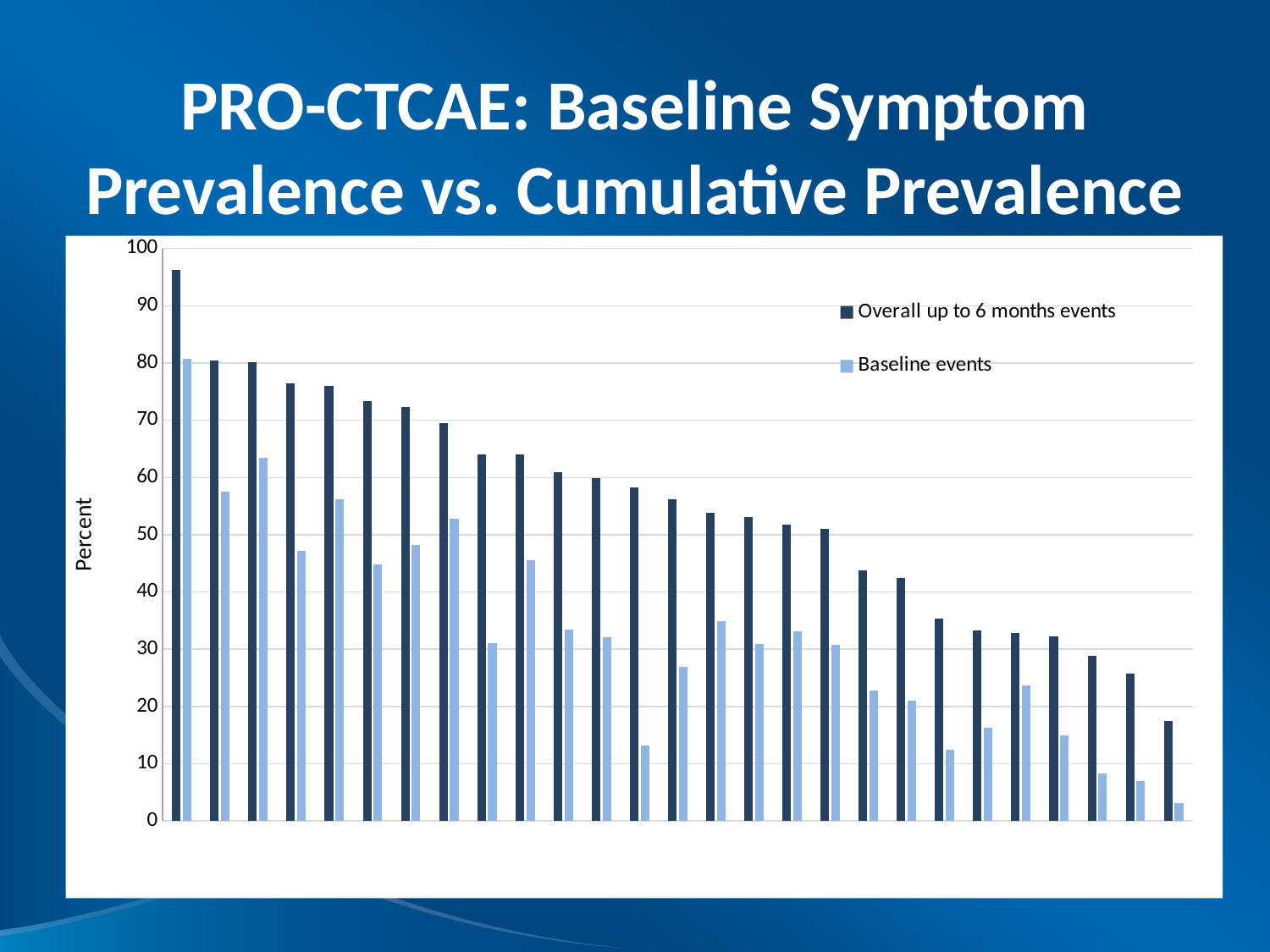
How many series does the legend list? 2 What kind of chart is shown on the slide? bar chart What is the highest value shown on the vertical axis? 100 Do the values for the 'Overall up to 6 months events' series rise or fall from left to right along the x axis? fall Which series contains the shortest bar in the chart? Baseline events What is the label on the vertical axis? Percent For the leftmost category, which series has the larger value: 'Overall up to 6 months events' or 'Baseline events'? Overall up to 6 months events Is the value of the rightmost 'Baseline events' bar greater or less than 10? less What are the two series named in the legend? Overall up to 6 months events; Baseline events Is the value of the rightmost 'Overall up to 6 months events' bar greater or less than 20? less Is the value of the leftmost 'Overall up to 6 months events' bar greater or less than 90? greater Which series contains the tallest bar in the chart? Overall up to 6 months events